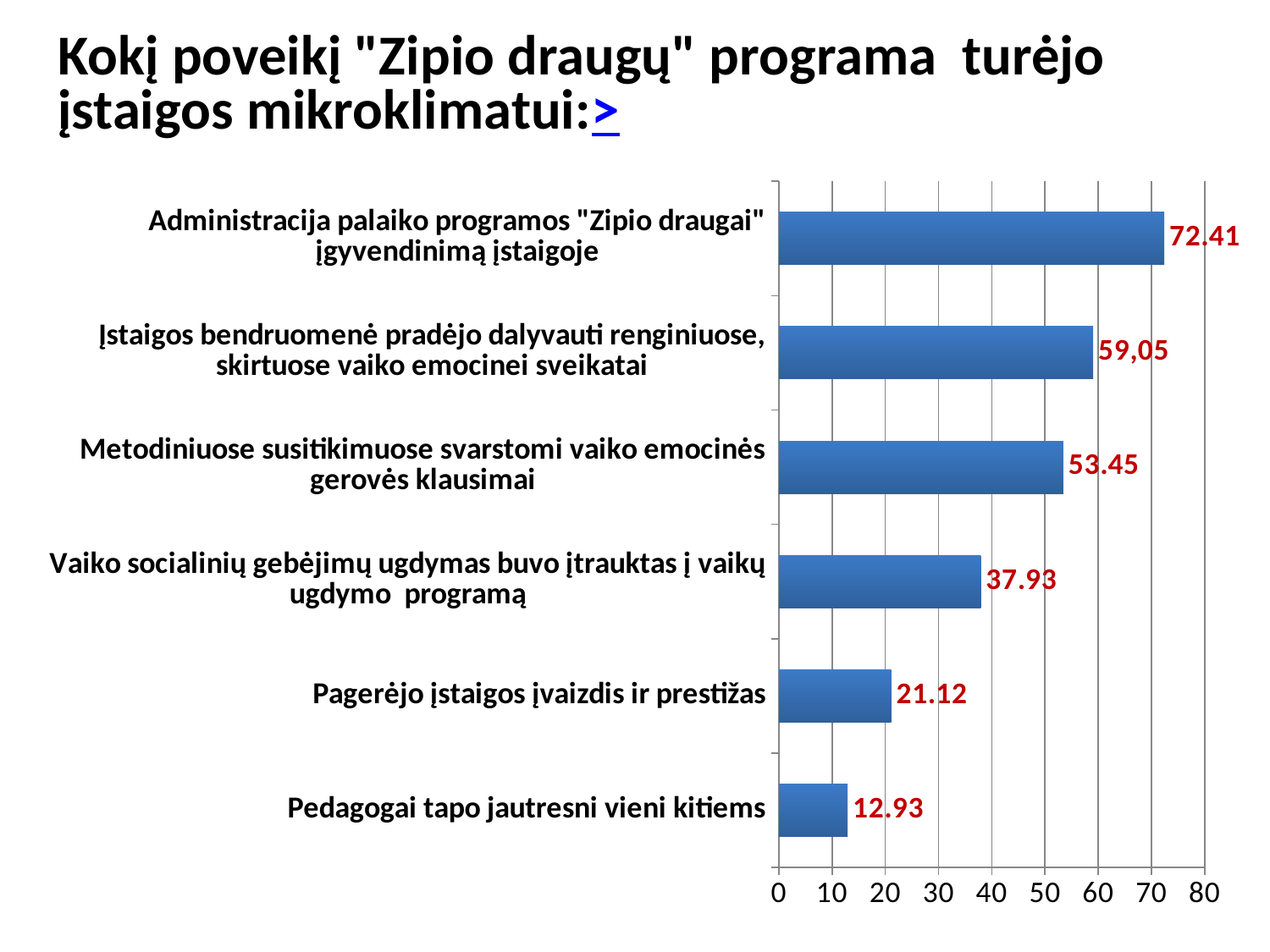
How many categories are shown in the chart? 6 What is the value for "Administracija palaiko programos "Zipio draugai" įgyvendinimą įstaigoje"? 72.41 What is the value for "Pedagogai tapo jautresni vieni kitiems"? 12.93 What kind of chart is shown on the slide? bar chart What is the difference between the highest and lowest values in the chart? 59.48 Which category has the highest value? Administracija palaiko programos "Zipio draugai" įgyvendinimą įstaigoje What is the value for "Pagerėjo įstaigos įvaizdis ir prestižas"? 21.12 What is the value for "Įstaigos bendruomenė pradėjo dalyvauti renginiuose, skirtuose vaiko emocinei sveikatai"? 59,05 Is the value for "Metodiniuose susitikimuose svarstomi vaiko emocinės gerovės klausimai" greater or less than 50? greater What is the difference between the values for "Metodiniuose susitikimuose svarstomi vaiko emocinės gerovės klausimai" and "Vaiko socialinių gebėjimų ugdymas buvo įtrauktas į vaikų ugdymo programą"? 15.52 Which is larger: the value for "Pagerėjo įstaigos įvaizdis ir prestižas" or the value for "Vaiko socialinių gebėjimų ugdymas buvo įtrauktas į vaikų ugdymo programą"? Vaiko socialinių gebėjimų ugdymas buvo įtrauktas į vaikų ugdymo programą Which category has the lowest value? Pedagogai tapo jautresni vieni kitiems